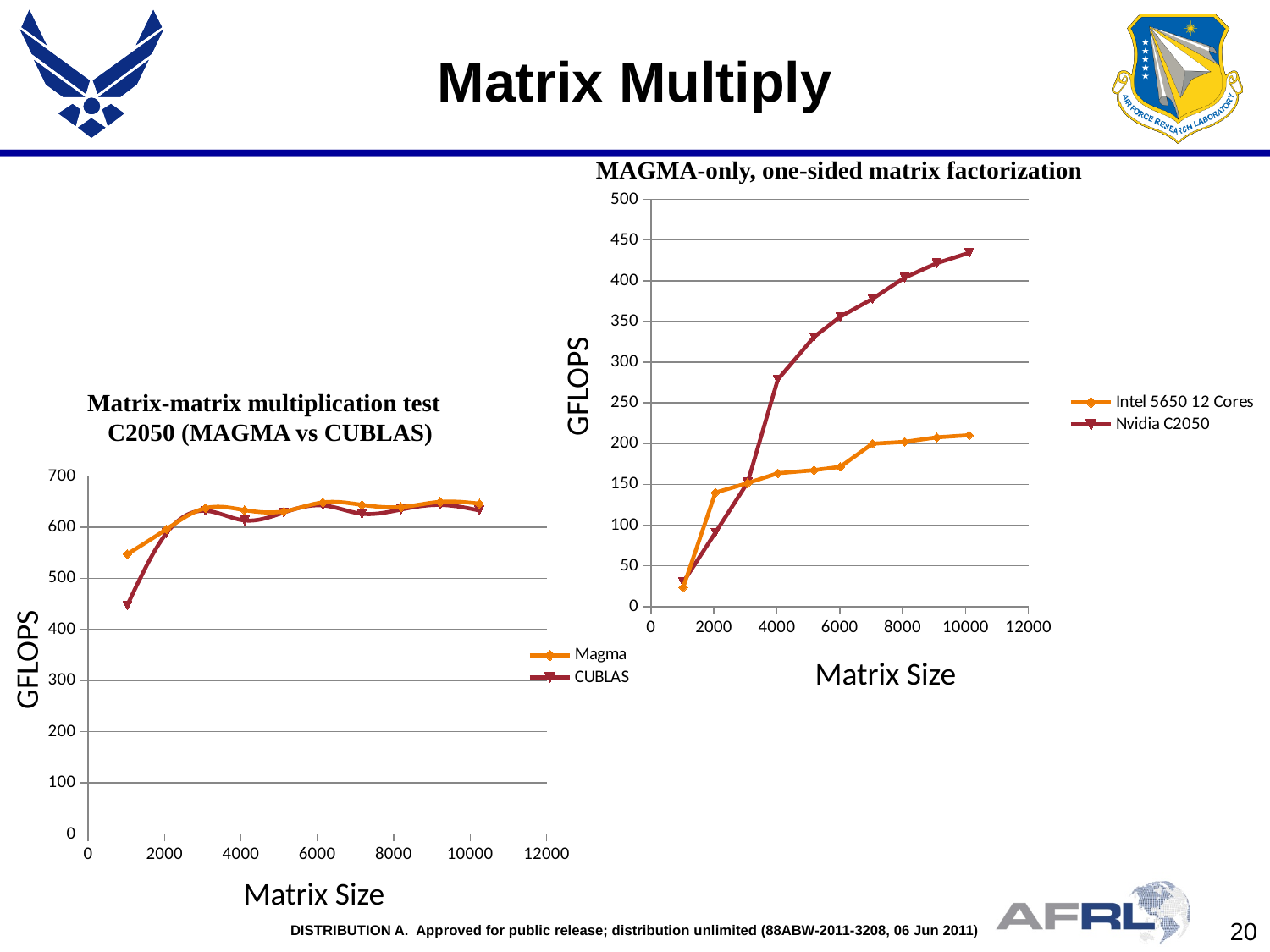
On the chart titled 'MAGMA-only, one-sided matrix factorization', how many series does the legend list? 2 On the 'MAGMA-only, one-sided matrix factorization' chart, is the value for Intel 5650 12 Cores at matrix size 10000 greater or less than 250? less On the 'MAGMA-only, one-sided matrix factorization' chart, is the value for Nvidia C2050 at matrix size 4000 greater or less than 250? greater On the 'MAGMA-only, one-sided matrix factorization' chart, is the value for Nvidia C2050 at matrix size 10000 greater or less than 400? greater On the 'MAGMA-only, one-sided matrix factorization' chart, which series has the larger value at matrix size 2000, Intel 5650 12 Cores or Nvidia C2050? Intel 5650 12 Cores On the chart titled 'Matrix-matrix multiplication test C2050 (MAGMA vs CUBLAS)', what are the two series named in the legend? Magma and CUBLAS On the 'Matrix-matrix multiplication test C2050 (MAGMA vs CUBLAS)' chart, which series has the larger value at matrix size 1000, Magma or CUBLAS? Magma What kind of chart is the 'MAGMA-only, one-sided matrix factorization' chart? line chart On the 'MAGMA-only, one-sided matrix factorization' chart, which series has the larger value at matrix size 10000, Intel 5650 12 Cores or Nvidia C2050? Nvidia C2050 On the 'MAGMA-only, one-sided matrix factorization' chart, does the Nvidia C2050 series rise or fall as matrix size increases? rise On the 'Matrix-matrix multiplication test C2050 (MAGMA vs CUBLAS)' chart, how many data points does the Magma series have? 10